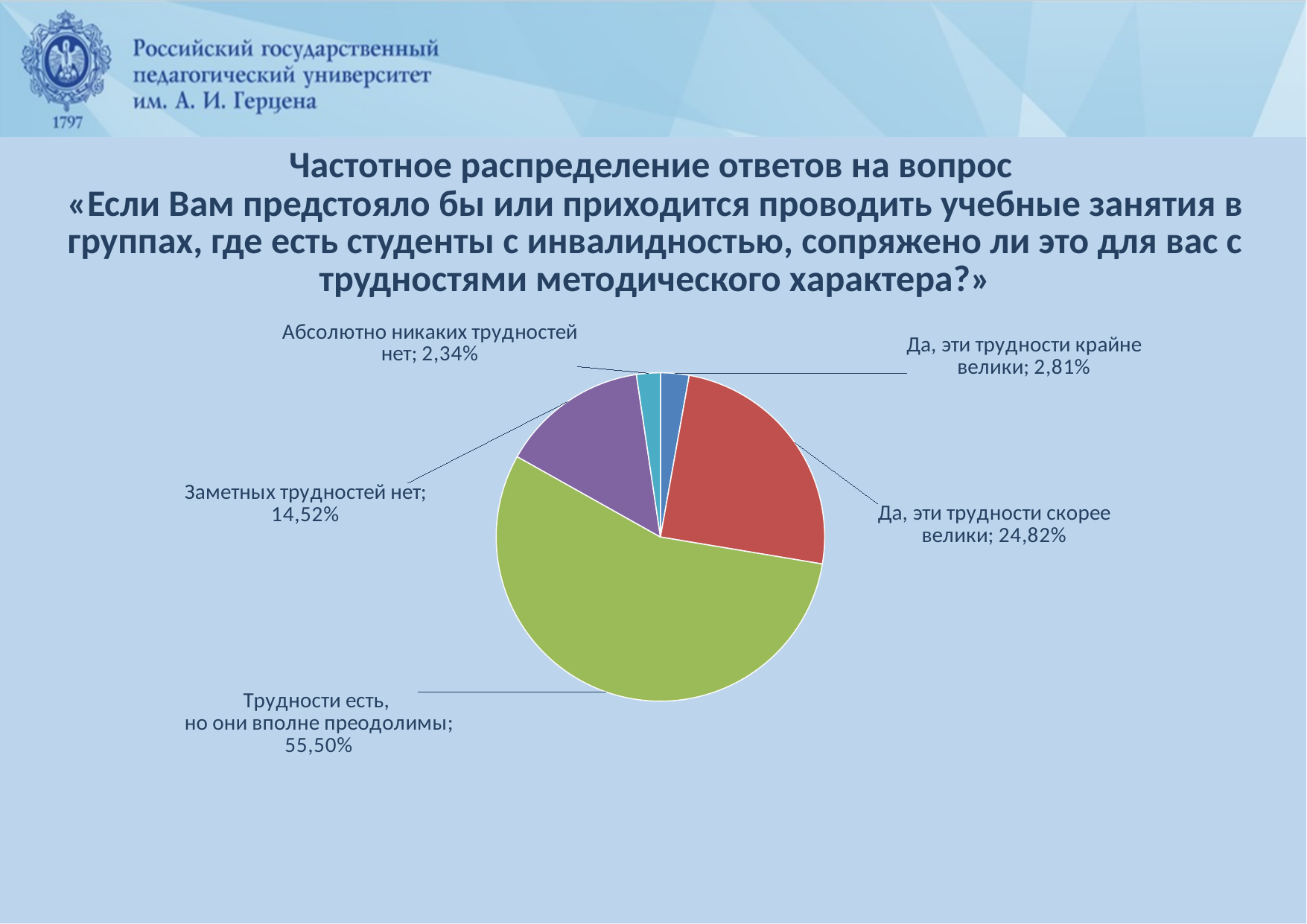
What share of responses is "Трудности есть, но они вполне преодолимы"? 55,50% What is the difference in percentage points between "Трудности есть, но они вполне преодолимы" and "Да, эти трудности скорее велики"? 30,68% What share of responses is "Абсолютно никаких трудностей нет"? 2,34% What kind of chart is shown on the slide? pie chart What share of responses is "Да, эти трудности крайне велики"? 2,81% What colour is the slice for "Трудности есть, но они вполне преодолимы"? green Which response has the smallest share of the pie? Абсолютно никаких трудностей нет Which response has the largest share of the pie? Трудности есть, но они вполне преодолимы What share of responses is "Да, эти трудности скорее велики"? 24,82% How many slices does the pie chart have? 5 Which is larger: the share for "Да, эти трудности скорее велики" or for "Заметных трудностей нет"? Да, эти трудности скорее велики What share of responses is "Заметных трудностей нет"? 14,52%